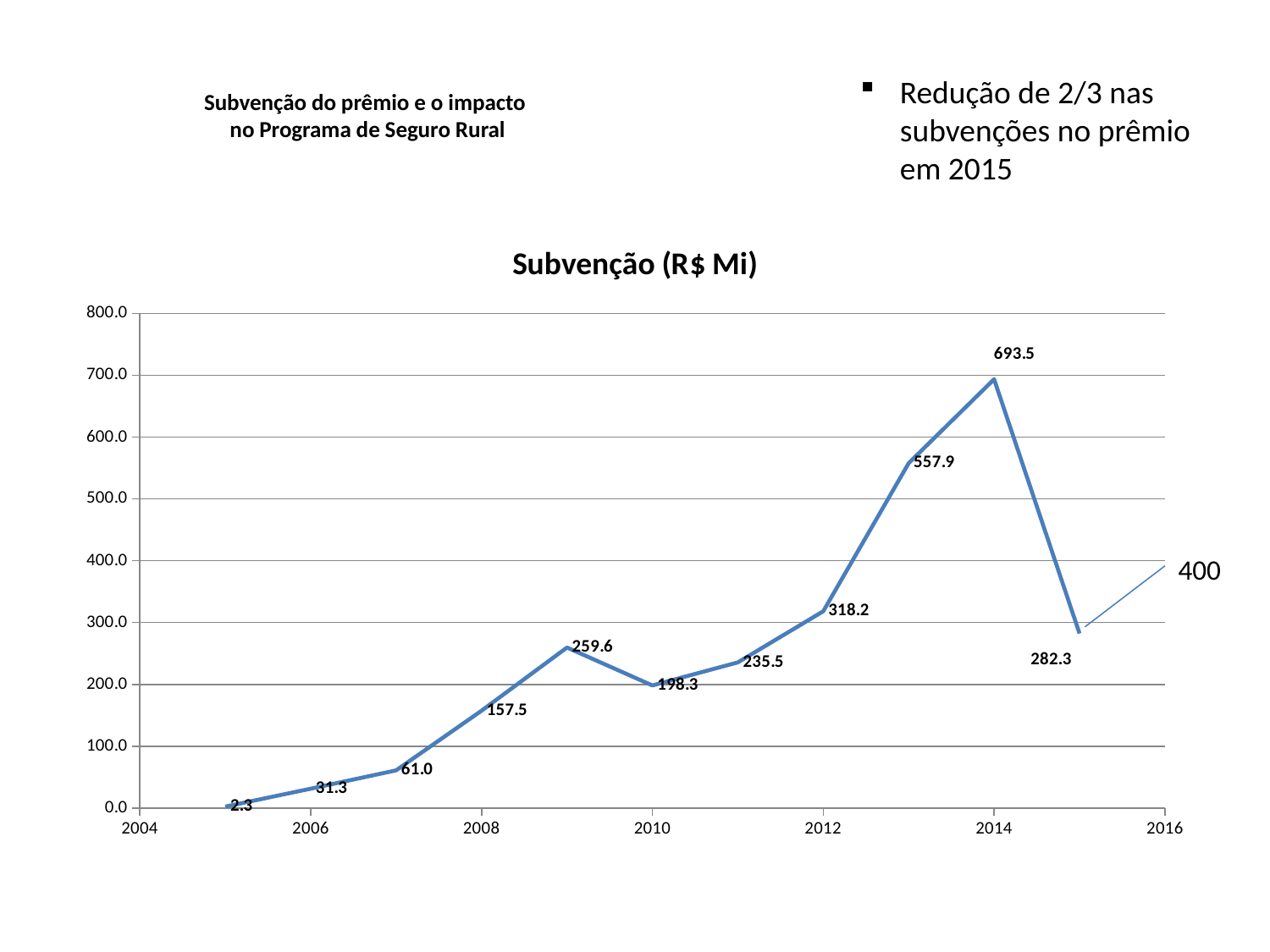
What is the value for 2014? 693.5 Which year has the lowest value? 2005 What type of chart is shown on the slide? line chart Is the value for 2013 greater or less than 500? greater How many data points have labelled values on the line? 11 Which year has the highest value? 2014 Which is larger, the value for 2009 or the value for 2010? 2009 What is the value for 2010? 198.3 What is the difference between the values for 2014 and 2015? 411.2 Does the value rise or fall from 2012 to 2014? rise What is the value for 2015? 282.3 What is the title of the chart? Subvenção (R$ Mi)